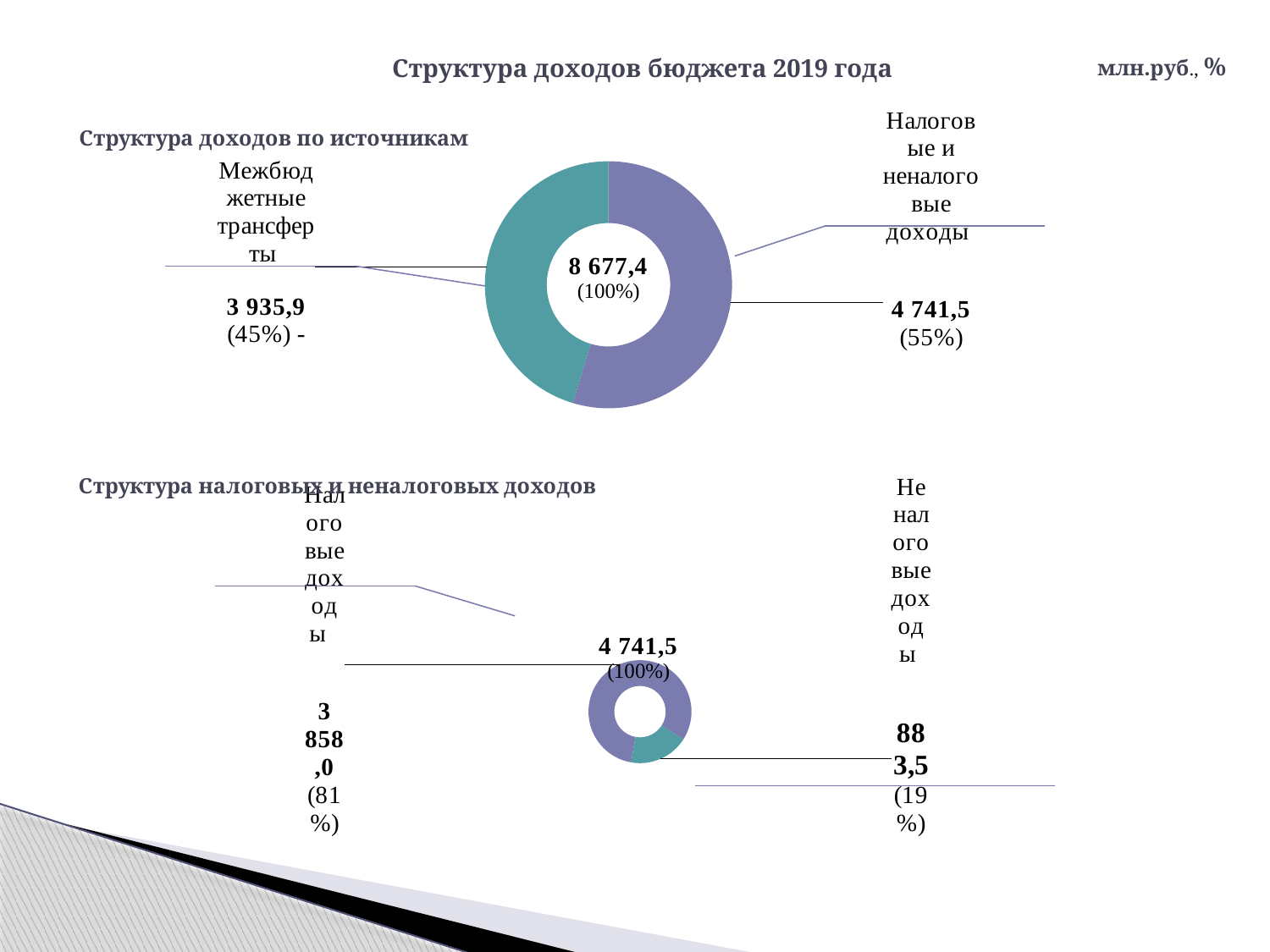
How many categories does the bottom chart 'Структура налоговых и неналоговых доходов' show? 2 What kind of chart is used in the top chart 'Структура доходов по источникам'? Donut (pie) chart In the top chart 'Структура доходов по источникам', what is the difference between Налоговые и неналоговые доходы and Межбюджетные трансферты? 805,6 In the bottom chart 'Структура налоговых и неналоговых доходов', what share of the total do Неналоговые доходы make up? 19% In the top chart 'Структура доходов по источникам', what is the value for Налоговые и неналоговые доходы? 4 741,5 In the top chart 'Структура доходов по источникам', which category is larger: Межбюджетные трансферты or Налоговые и неналоговые доходы? Налоговые и неналоговые доходы In the bottom chart 'Структура налоговых и неналоговых доходов', what is the value for Неналоговые доходы? 883,5 In the top chart 'Структура доходов по источникам', what is the value for Межбюджетные трансферты? 3 935,9 In the bottom chart 'Структура налоговых и неналоговых доходов', what is the value for Налоговые доходы? 3 858,0 In the top chart 'Структура доходов по источникам', what share of the total do Межбюджетные трансферты make up? 45% In the top chart 'Структура доходов по источникам', what is the total shown in the centre of the donut? 8 677,4 In the bottom chart 'Структура налоговых и неналоговых доходов', which category is the smallest? Неналоговые доходы